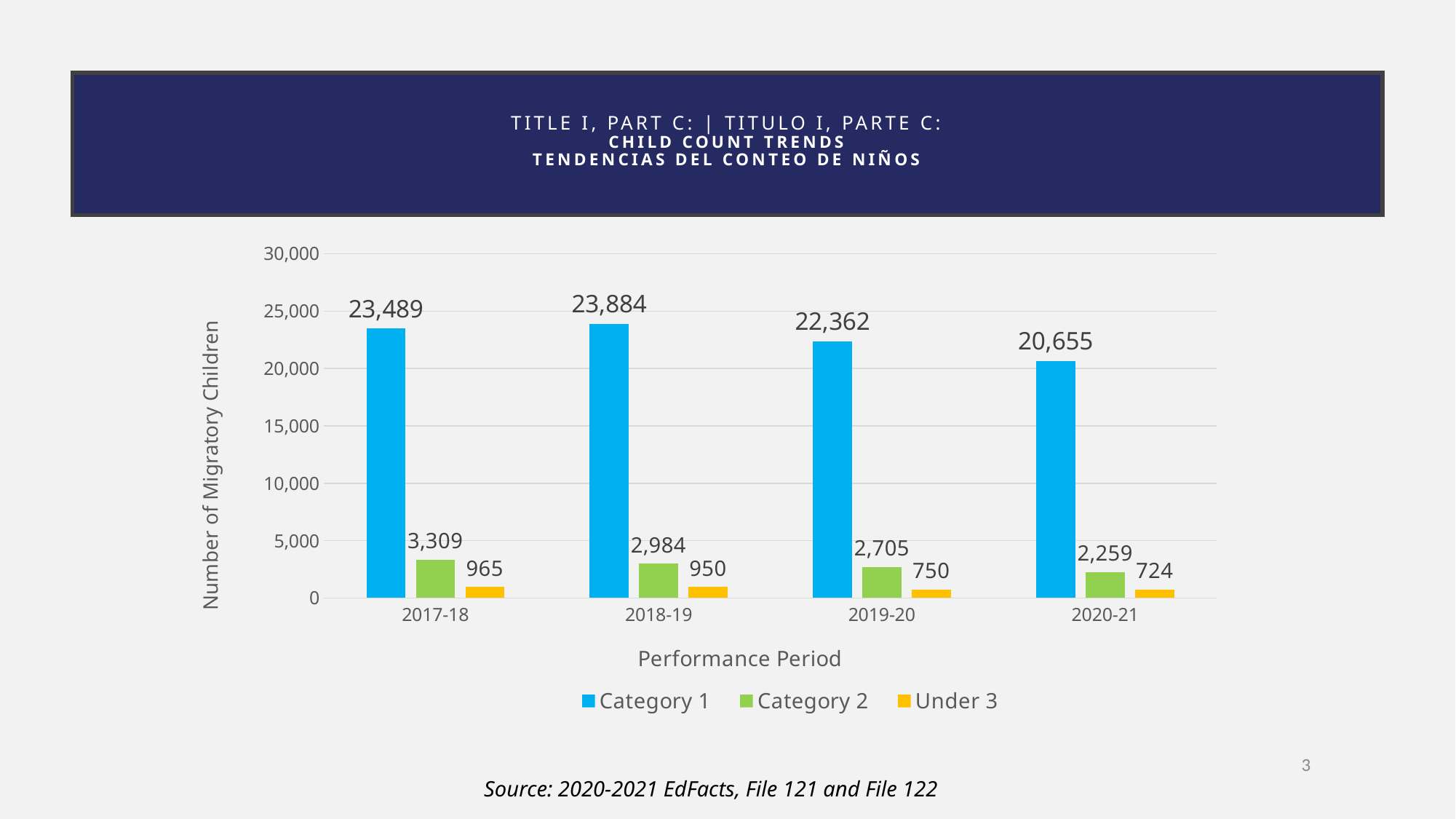
How many performance periods are shown on the x axis? 4 What is the Category 2 value for 2020-21? 2,259 Is the Category 1 value for 2019-20 greater or less than 20,000? greater What is the Category 1 value for 2018-19? 23,884 How many series does the legend list? 3 What is the Under 3 value for 2019-20? 750 Do the Category 2 values rise or fall from 2017-18 to 2020-21? fall Which performance period has the highest Category 1 value? 2018-19 What is the difference between the Category 1 values for 2017-18 and 2020-21? 2,834 Which performance period has the lowest Category 2 value? 2020-21 What kind of chart is shown on the slide? bar chart Which is larger, the Under 3 value for 2017-18 or for 2018-19? 2017-18